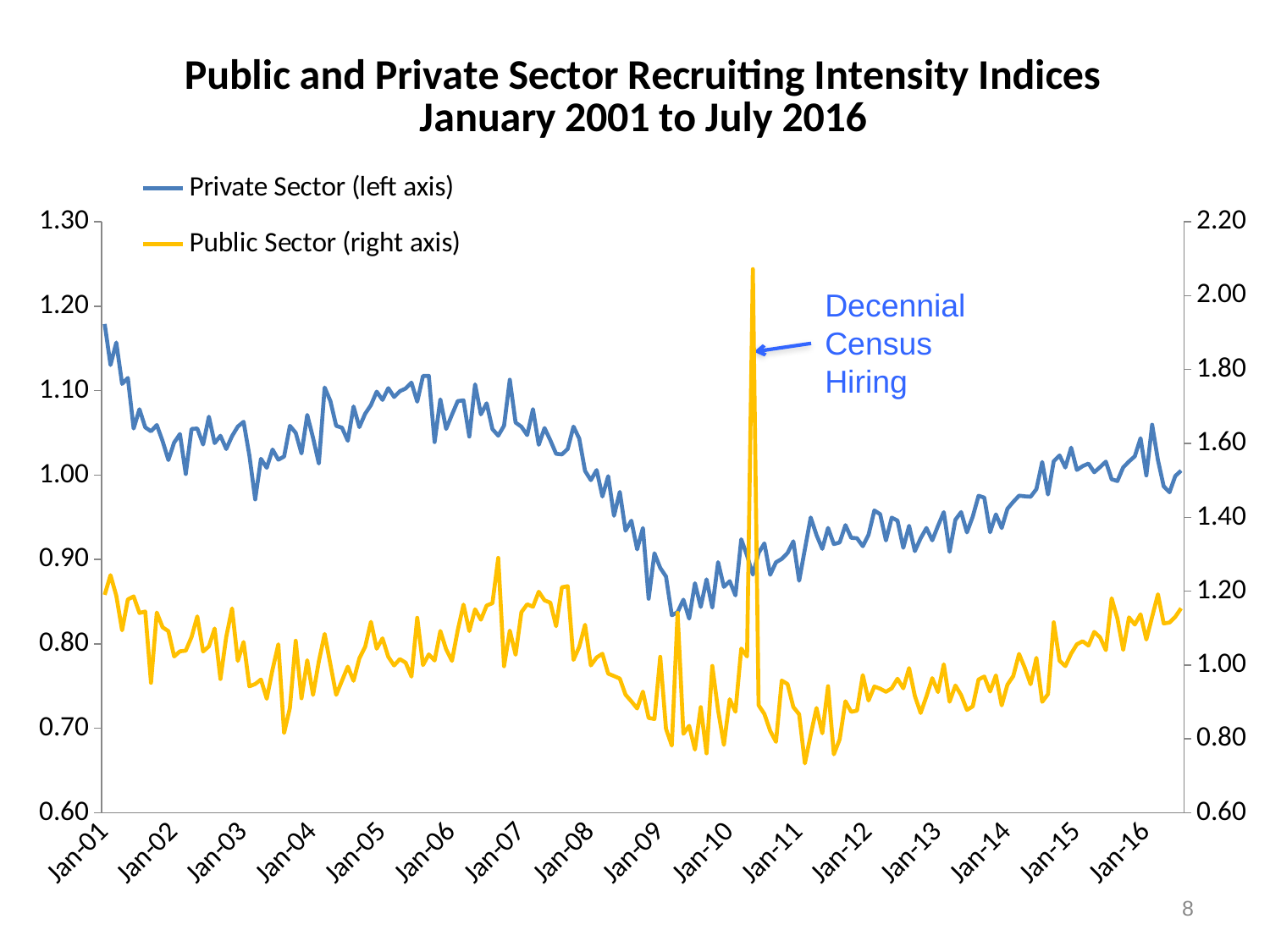
What event does the annotation attribute the sharp spike in the Public Sector series to? Decennial Census Hiring In which year does the Public Sector series reach its highest value? 2010 Which axis is the Public Sector series plotted against, according to the legend? Right axis Does the Private Sector series rise or fall between Jan-07 and Jan-09? Fall How many year labels are shown on the x axis? 16 Does the Private Sector series rise or fall overall between Jan-10 and Jan-16? Rise Is the peak value of the Public Sector series greater or less than 2.00 on the right axis? greater What kind of chart is shown on the slide? Line chart How many series does the legend list? 2 What is the title of the chart? Public and Private Sector Recruiting Intensity Indices January 2001 to July 2016 Is the Private Sector value at Jan-01 greater or less than 1.10 on the left axis? greater